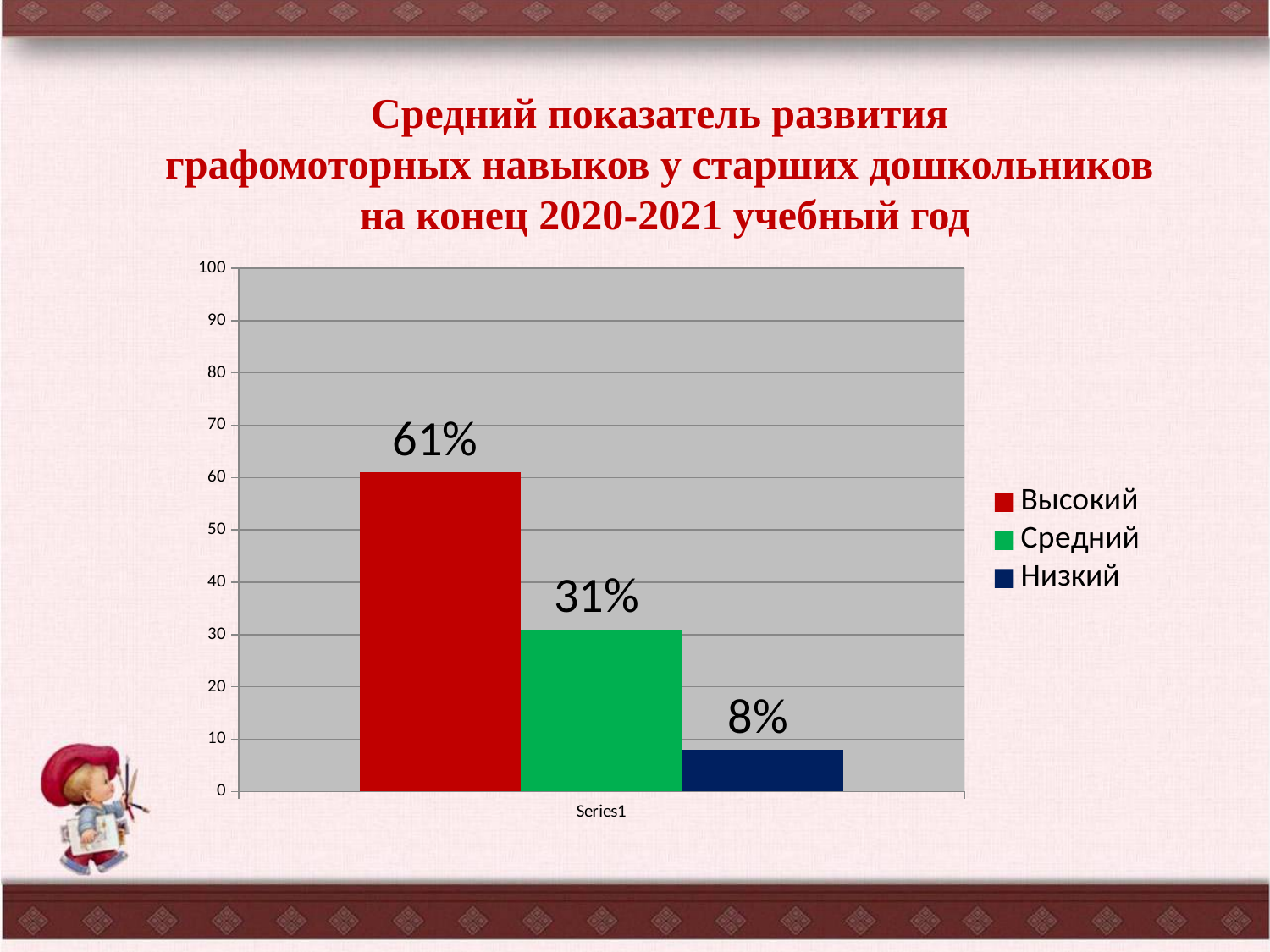
Which is larger, the value for Средний or the value for Низкий? Средний Is the value for Высокий greater or less than 50? greater What is the value for Низкий? 8% What kind of chart is shown on the slide? bar chart What colour is the bar for Низкий? dark blue What is the value for Высокий? 61% What is the difference between the values for Высокий and Средний? 30% How many series does the legend list? 3 Which series has the highest value? Высокий Which series has the lowest value? Низкий What is the difference between the values for Средний and Низкий? 23% What is the value for Средний? 31%